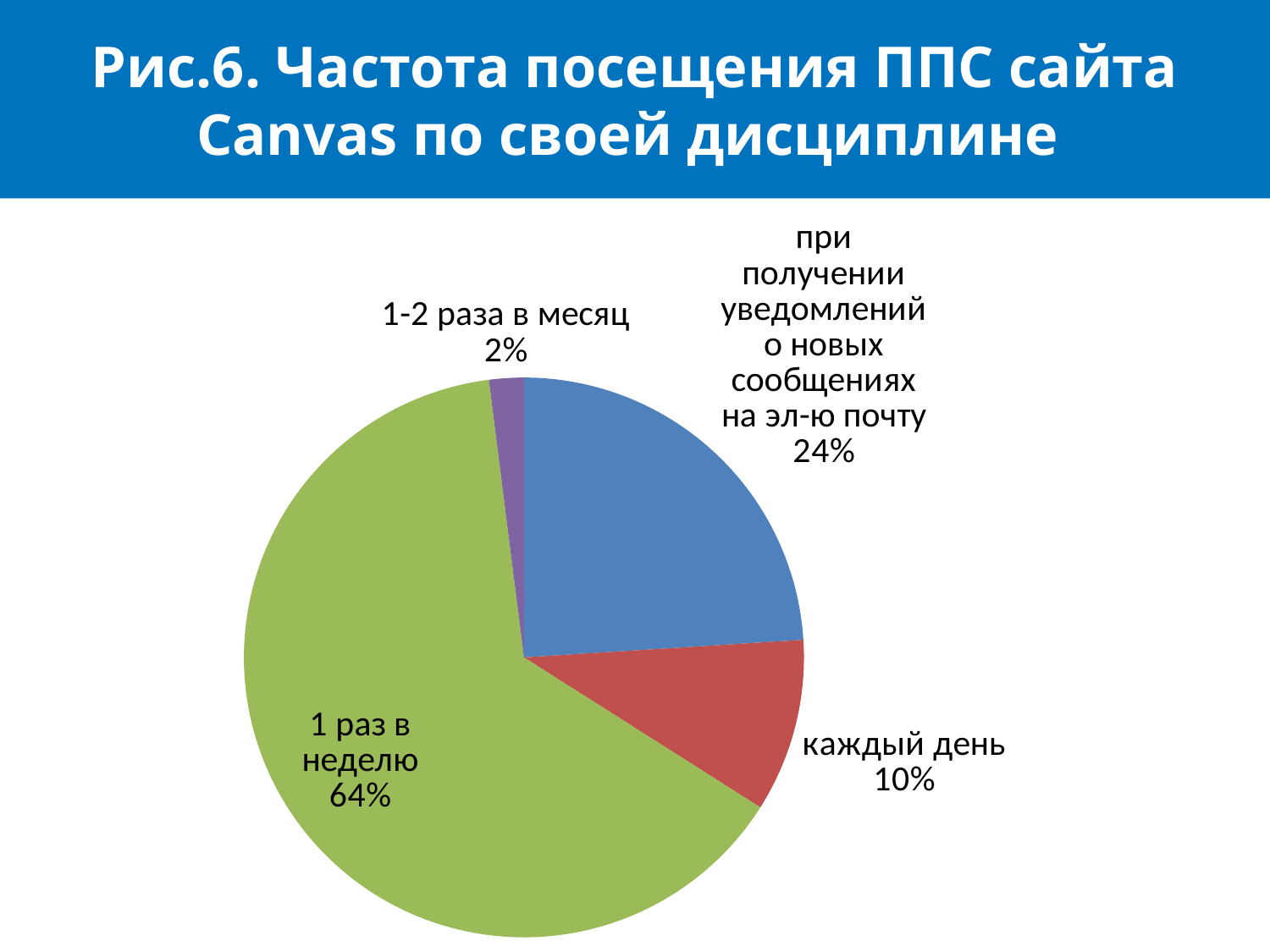
Which is larger: "каждый день" or "при получении уведомлений о новых сообщениях на эл-ю почту"? при получении уведомлений о новых сообщениях на эл-ю почту What colour is the slice for "1 раз в неделю"? green What is the value for "каждый день"? 10% What is the value for "при получении уведомлений о новых сообщениях на эл-ю почту"? 24% What is the difference between "1 раз в неделю" and "каждый день"? 54% What is the title of the chart? Рис.6. Частота посещения ППС сайта Canvas по своей дисциплине What share of the pie does "1 раз в неделю" have? 64% What kind of chart is shown on the slide? pie chart What is the value for "1-2 раза в месяц"? 2% Which category has the smallest slice? 1-2 раза в месяц Which category has the largest slice? 1 раз в неделю How many slices does the pie chart have? 4